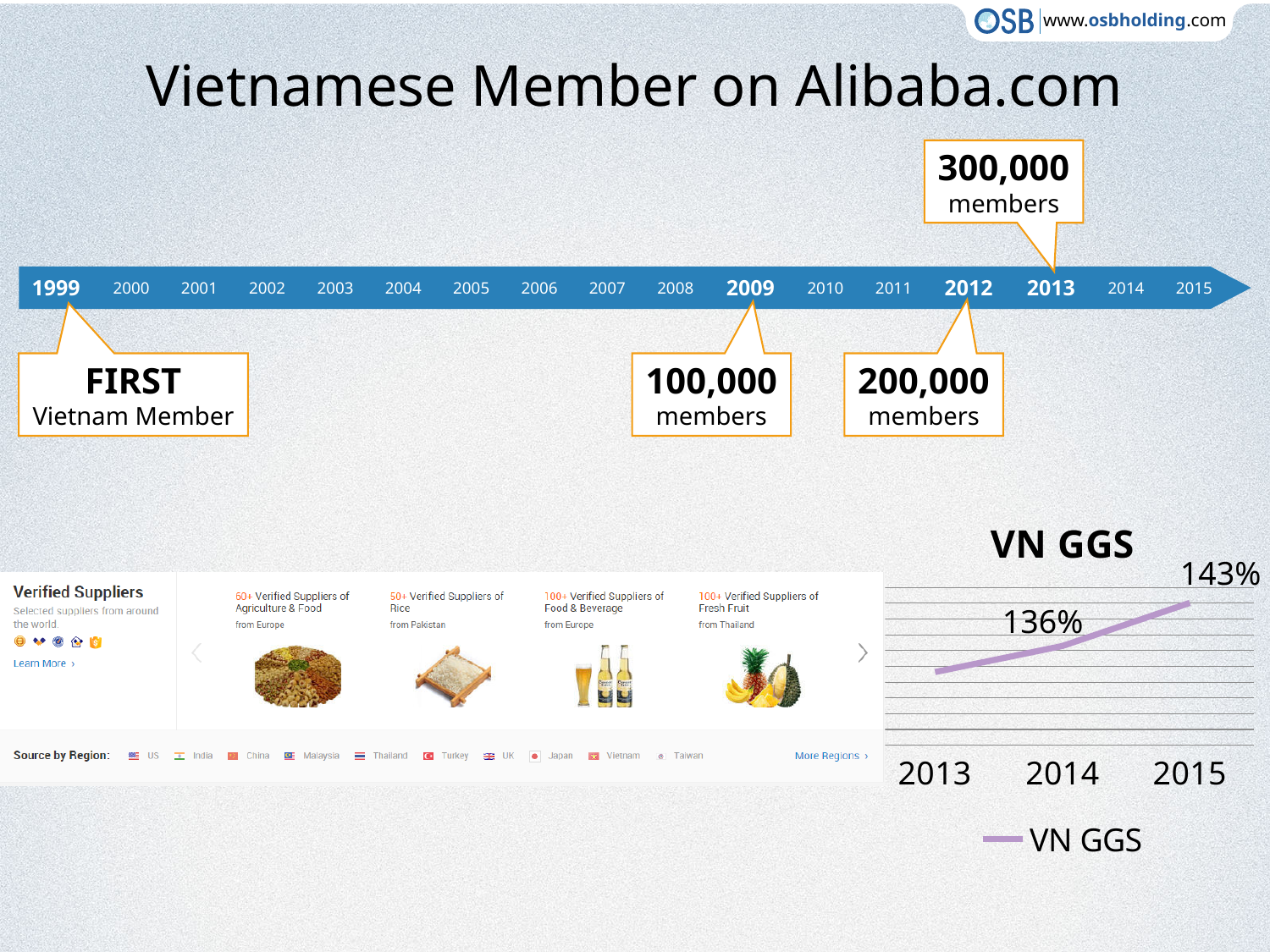
In the VN GGS chart, which year has the highest value? 2015 What kind of chart is the VN GGS chart? line chart In the VN GGS chart, which is larger, the value for 2014 or the value for 2015? 2015 In the VN GGS chart, which year has the lowest value? 2013 In the VN GGS chart, do the values rise or fall from 2013 to 2015? rise How many series does the legend of the VN GGS chart list? 1 How many years are shown on the x axis of the VN GGS chart? 3 What is the title of the chart at the bottom right of the slide? VN GGS What is the name of the series shown in the legend of the VN GGS chart? VN GGS